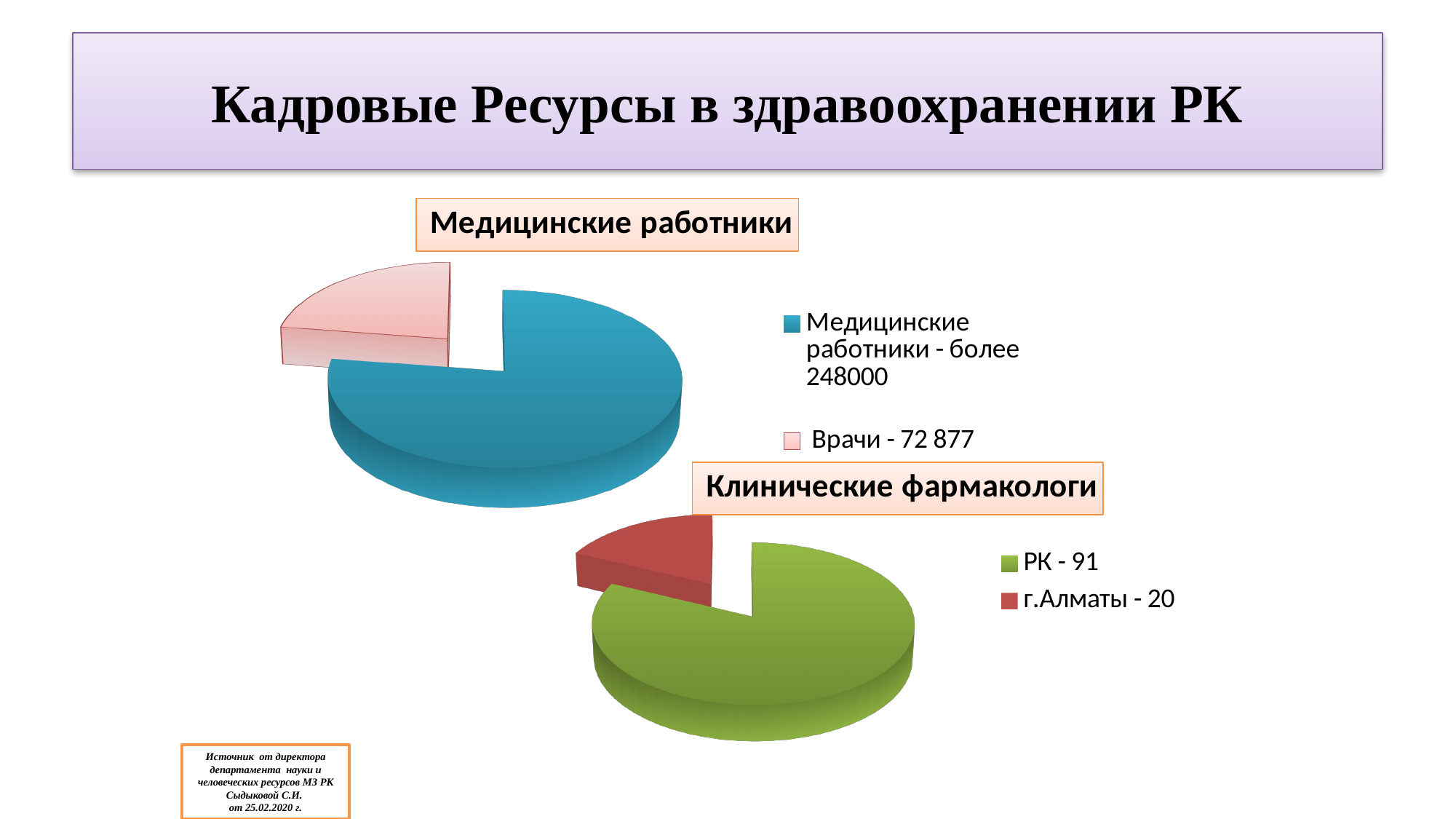
In the "Медицинские работники" chart, what value is given for Врачи? 72 877 In the "Клинические фармакологи" chart, what is the difference between the values for РК and г.Алматы? 71 In the "Клинические фармакологи" chart, what colour is the slice for г.Алматы? red What kind of chart is the "Клинические фармакологи" chart? pie chart What kind of chart is the "Медицинские работники" chart? pie chart In the "Медицинские работники" chart, what value is given for Медицинские работники? более 248000 How many slices does the "Медицинские работники" chart have? 2 In the "Медицинские работники" chart, which slice is larger, Медицинские работники or Врачи? Медицинские работники In the "Клинические фармакологи" chart, what value is given for г.Алматы? 20 How many entries does the legend of the "Клинические фармакологи" chart list? 2 In the "Клинические фармакологи" chart, which category has the larger value, РК or г.Алматы? РК In the "Клинические фармакологи" chart, what value is given for РК? 91